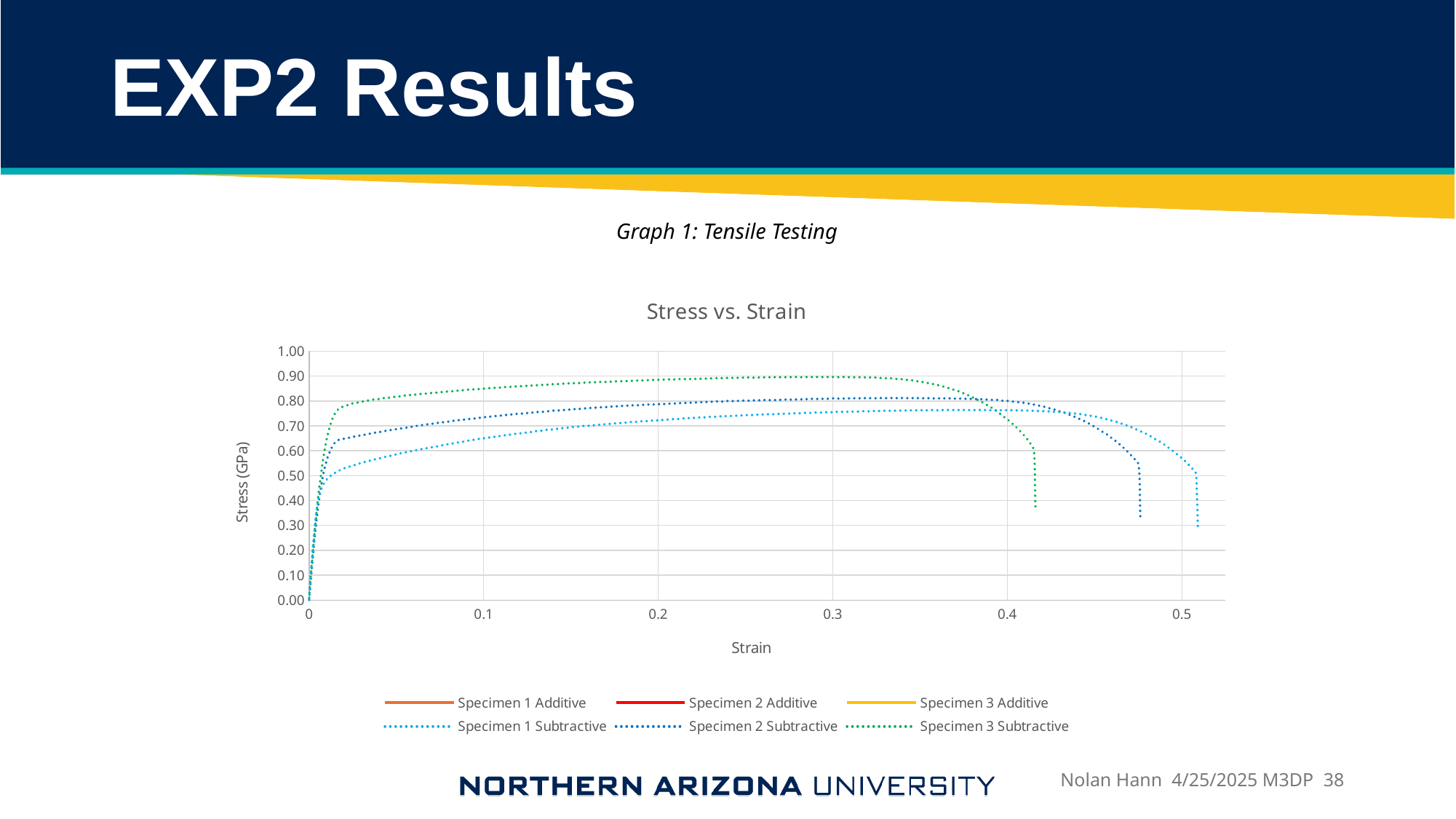
What type of chart is shown on the slide? Line chart Is the peak stress of Specimen 1 Subtractive greater or less than 0.90 GPa? less Is the strain at which Specimen 2 Subtractive fails greater or less than 0.5? less What is the label of the vertical axis of the Stress vs. Strain chart? Stress (GPa) How many series does the legend of the Stress vs. Strain chart list? 6 Which plotted series reaches the highest stress in the Stress vs. Strain chart? Specimen 3 Subtractive Which plotted series extends to the largest strain before failure in the Stress vs. Strain chart? Specimen 1 Subtractive Which reaches a higher peak stress, Specimen 2 Subtractive or Specimen 1 Subtractive? Specimen 2 Subtractive Which plotted series reaches the lowest peak stress in the Stress vs. Strain chart? Specimen 1 Subtractive Is the peak stress of Specimen 3 Subtractive greater or less than 0.80 GPa? greater What is the title of the chart on the slide? Stress vs. Strain Which plotted series fails at the smallest strain in the Stress vs. Strain chart? Specimen 3 Subtractive